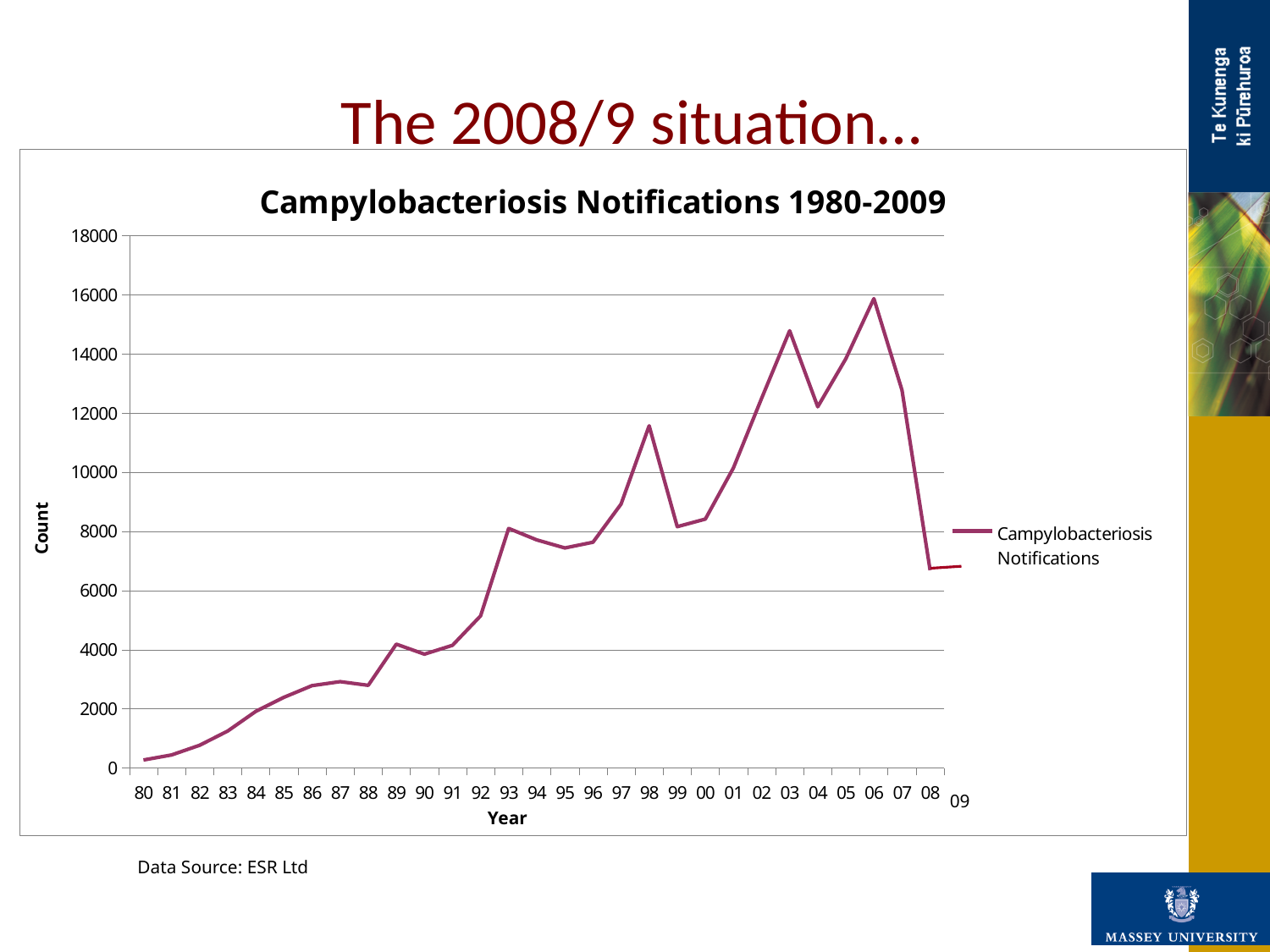
Which year has the larger count, 03 or 04? 03 What is the label on the y axis? Count How many years are plotted along the x axis? 30 Is the value for 98 greater or less than 10000? greater Is the value for 84 greater or less than 4000? less What kind of chart is shown on the slide? line chart Is the value for 08 greater or less than 8000? less In which year is the count of Campylobacteriosis Notifications lowest? 80 How many series does the legend list? 1 In which year is the count of Campylobacteriosis Notifications highest? 06 What is the title of the chart? Campylobacteriosis Notifications 1980-2009